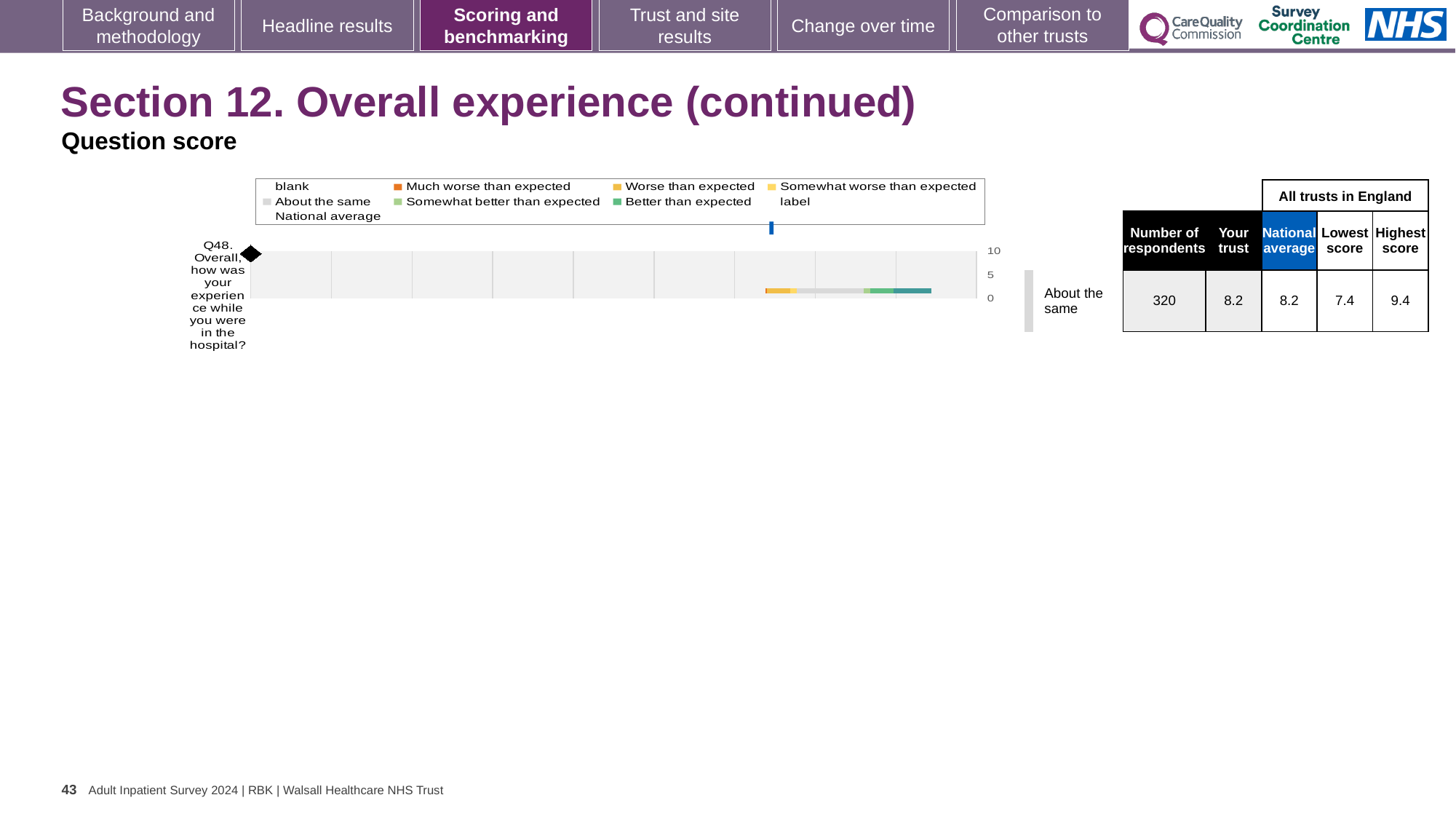
What kind of chart is shown on the slide for Q48? bar chart In the table beside the chart, what is the 'Your trust' score for Q48? 8.2 According to the label beside the chart, which benchmark category does Q48 fall into? About the same What is the difference between the highest score and the lowest score for Q48 in the table beside the chart? 2.0 In the table beside the chart, what is the lowest score among all trusts in England for Q48? 7.4 In the table beside the chart, what is the number of respondents for Q48? 320 What is the highest value shown on the chart's axis? 10 In the table beside the chart, what is the highest score among all trusts in England for Q48? 9.4 Which question is plotted in the chart? Q48. Overall, how was your experience while you were in the hospital? How many questions (categories) are plotted in the chart? 1 In the table beside the chart, what is the national average score for Q48? 8.2 Is the 'Your trust' score for Q48 larger than, smaller than, or equal to the national average? equal